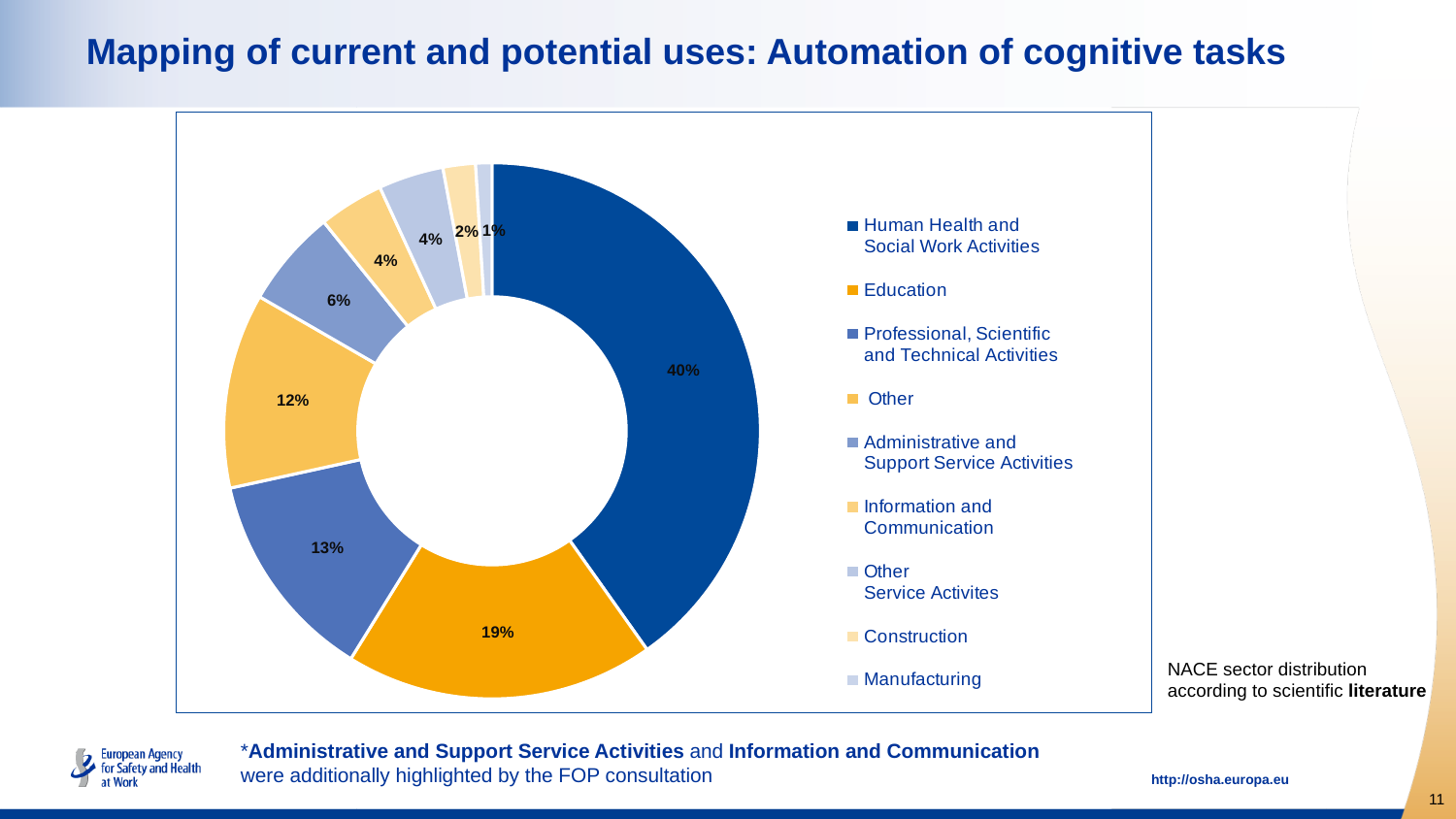
What is the difference in percentage points between Construction and Manufacturing? 1 Which sector has the largest share in the chart? Human Health and Social Work Activities What percentage is shown for Manufacturing? 1% Which sector has the smallest share in the chart? Manufacturing What percentage is shown for Education? 19% What share of the chart is Human Health and Social Work Activities? 40% What kind of chart is shown on the slide? doughnut chart What percentage is shown for Professional, Scientific and Technical Activities? 13% Which has a larger share, Professional, Scientific and Technical Activities or Other? Professional, Scientific and Technical Activities What percentage is shown for Administrative and Support Service Activities? 6% What is the difference in percentage points between Human Health and Social Work Activities and Education? 21 How many sectors does the legend list? 9